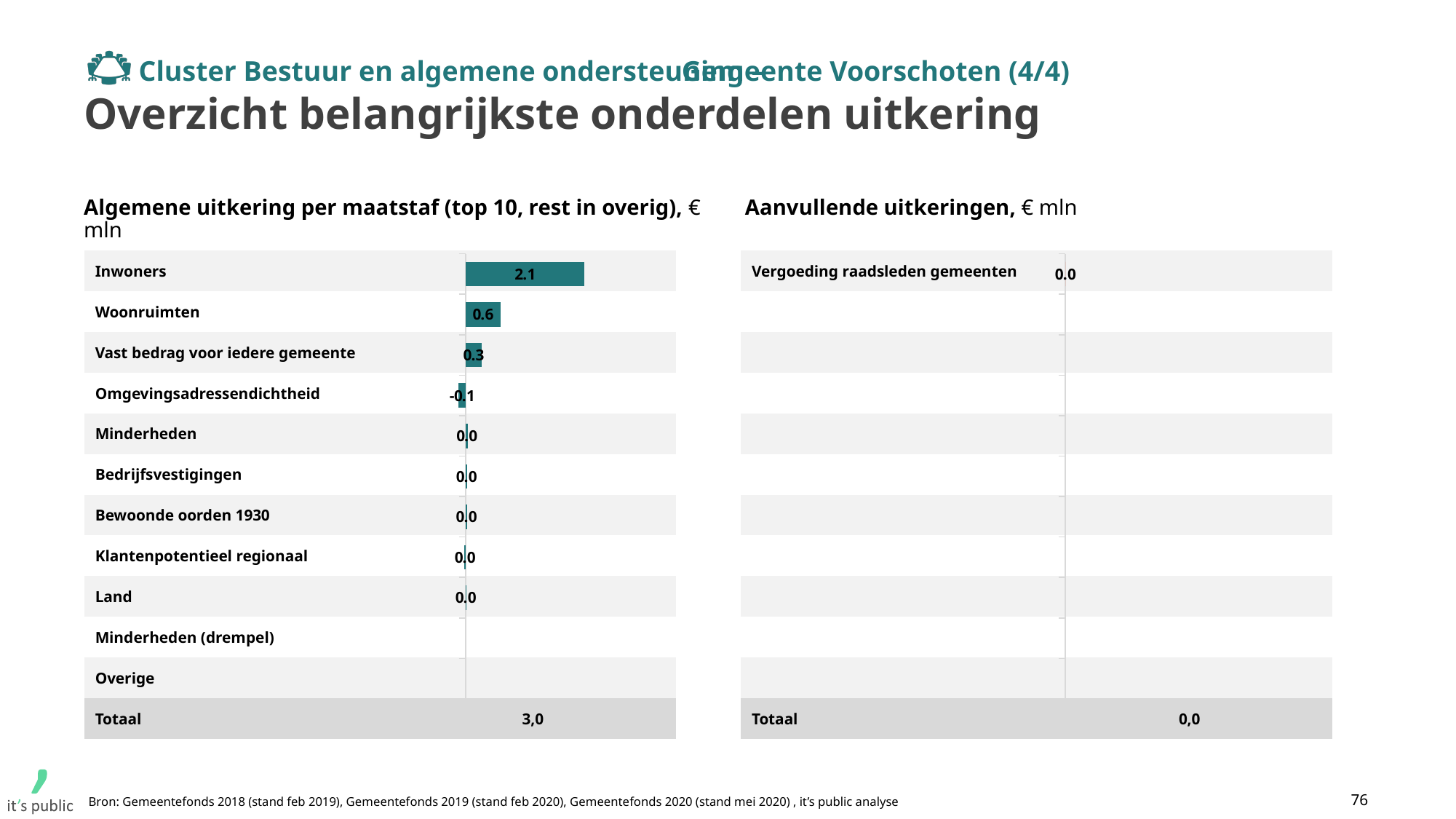
In the left chart 'Algemene uitkering per maatstaf', what is the difference between the values for Inwoners and Woonruimten? 1.5 In the left chart 'Algemene uitkering per maatstaf', which is larger: Woonruimten or Vast bedrag voor iedere gemeente? Woonruimten In the left chart 'Algemene uitkering per maatstaf', what is the value for Woonruimten? 0.6 In the left chart 'Algemene uitkering per maatstaf', what is the value for Vast bedrag voor iedere gemeente? 0.3 In the right chart 'Aanvullende uitkeringen', what is the Totaal value shown? 0,0 In the left chart 'Algemene uitkering per maatstaf', what is the value for Inwoners? 2.1 In the left chart 'Algemene uitkering per maatstaf', which category has the lowest value? Omgevingsadressendichtheid In the right chart 'Aanvullende uitkeringen', what is the value for Vergoeding raadsleden gemeenten? 0,0 In the left chart 'Algemene uitkering per maatstaf', what is the Totaal value shown? 3,0 In the left chart 'Algemene uitkering per maatstaf', which category has the highest value? Inwoners What kind of chart is the left chart 'Algemene uitkering per maatstaf'? Bar chart In the left chart 'Algemene uitkering per maatstaf', what is the value for Omgevingsadressendichtheid? -0.1